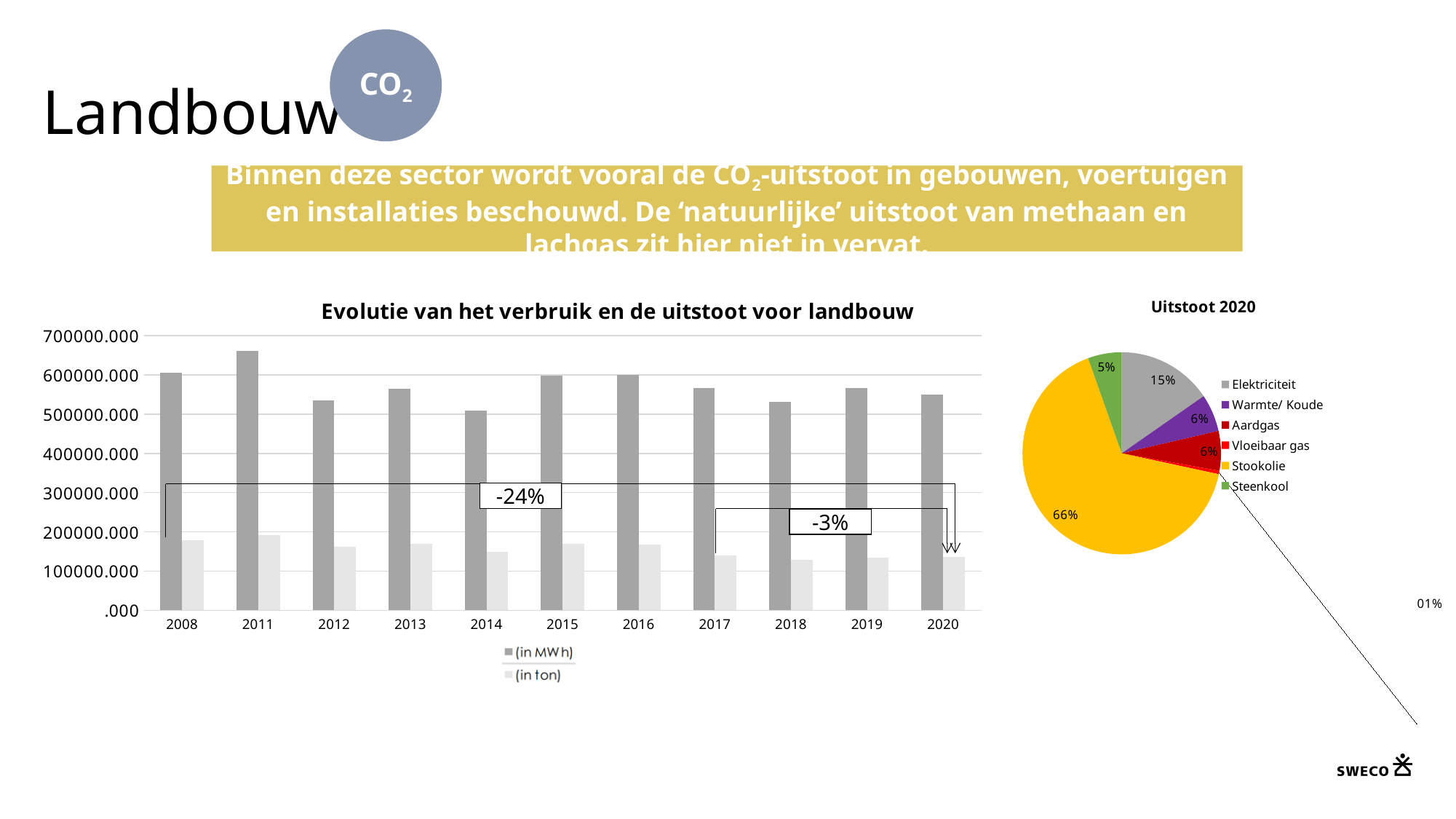
In the pie chart 'Uitstoot 2020', which category has the largest slice? Stookolie In the pie chart 'Uitstoot 2020', how many categories does the legend list? 6 What kind of chart is 'Evolutie van het verbruik en de uitstoot voor landbouw'? bar chart In the chart 'Evolutie van het verbruik en de uitstoot voor landbouw', how many years are shown on the x axis? 11 In the pie chart 'Uitstoot 2020', what share does Elektriciteit have? 15% In the chart 'Evolutie van het verbruik en de uitstoot voor landbouw', is the (in ton) value for 2008 greater or less than 100000.000? greater In the chart 'Evolutie van het verbruik en de uitstoot voor landbouw', is the (in MWh) value for 2014 greater or less than 600000.000? less In the chart 'Evolutie van het verbruik en de uitstoot voor landbouw', what percentage change is annotated between 2008 and 2020? -24% In the chart 'Evolutie van het verbruik en de uitstoot voor landbouw', which year has the highest value for (in MWh)? 2011 How many series does the legend of 'Evolutie van het verbruik en de uitstoot voor landbouw' list? 2 In the pie chart 'Uitstoot 2020', what is the difference between the shares of Stookolie and Elektriciteit? 51% In the pie chart 'Uitstoot 2020', what share does Stookolie have? 66%